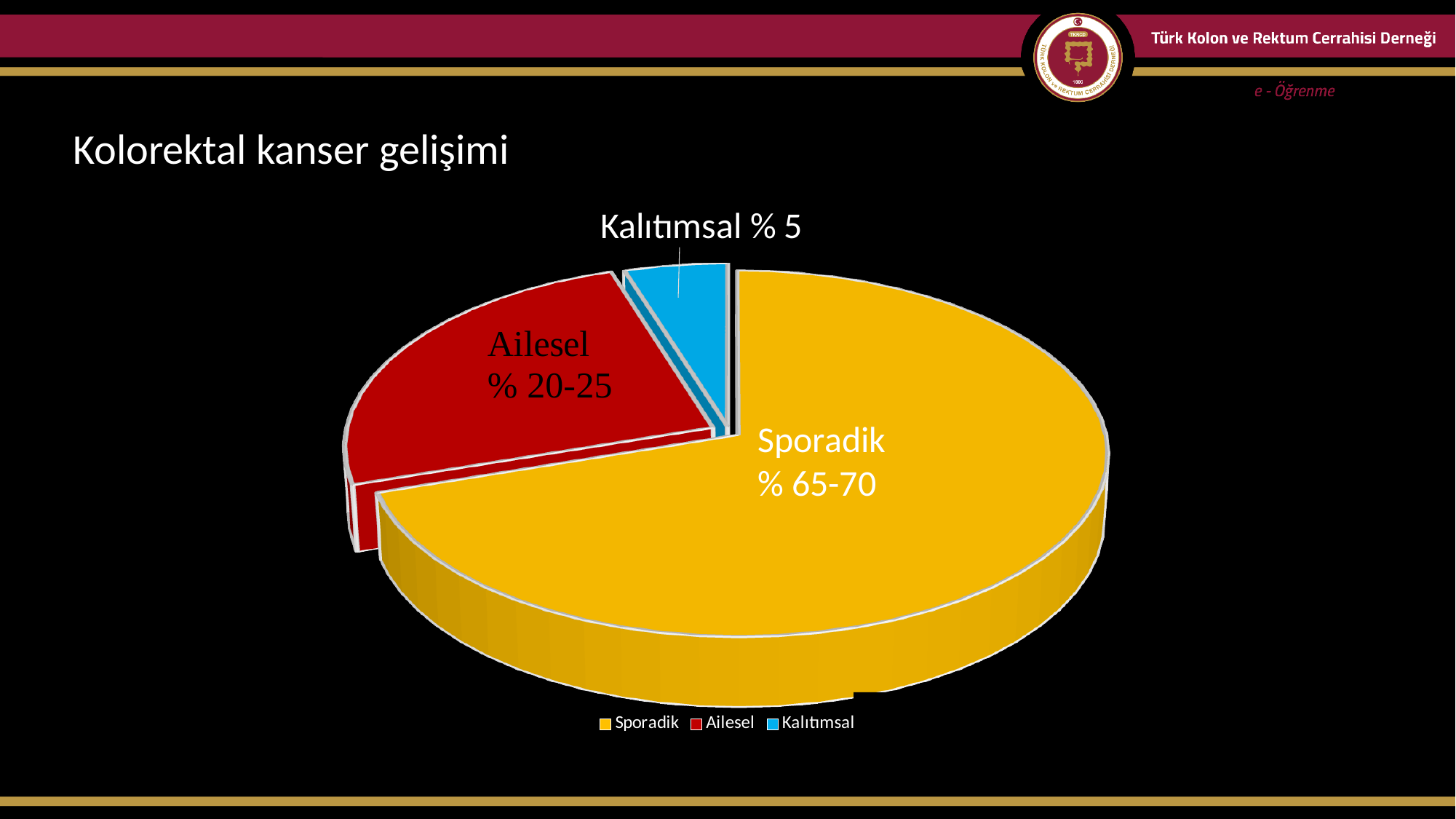
Which slice is the largest in the pie chart? Sporadik Which slice is larger, Ailesel or Kalıtımsal? Ailesel Which slice is the smallest in the pie chart? Kalıtımsal What percentage is shown for the Ailesel slice? % 20-25 Which slice is larger, Sporadik or Ailesel? Sporadik What colour is the Kalıtımsal slice? blue How many slices does the pie chart have? 3 What percentage is shown for the Kalıtımsal slice? % 5 What is the title of the slide containing the chart? Kolorektal kanser gelişimi How many entries does the legend list? 3 What percentage is shown for the Sporadik slice? % 65-70 What kind of chart is shown on the slide? pie chart